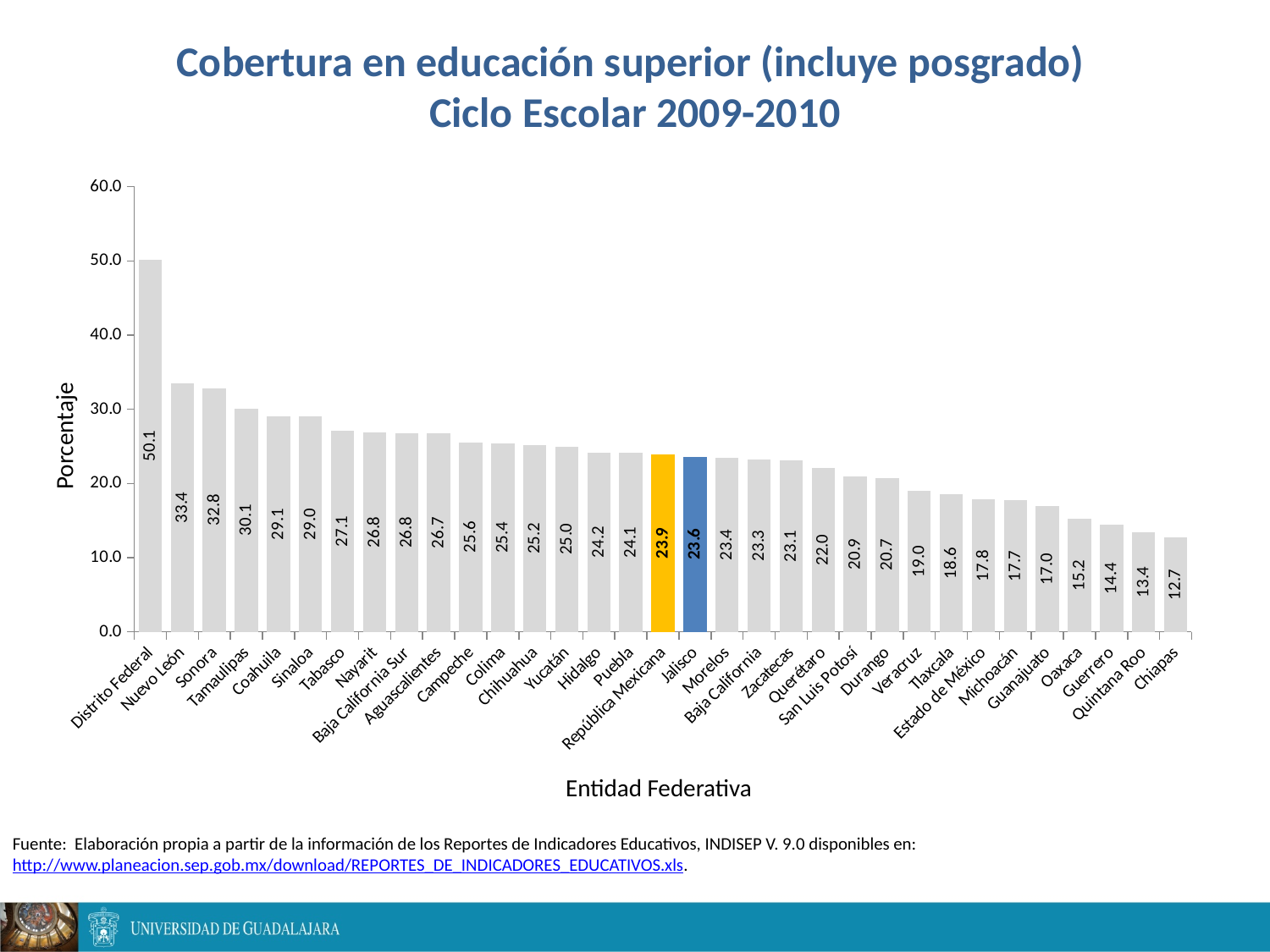
How many bars are shown in the chart? 33 What is the value for República Mexicana? 23.9 What kind of chart is shown on the slide? bar chart What is the value for Jalisco? 23.6 Which entidad federativa has the lowest value? Chiapas Do the values rise or fall from left to right along the x axis? fall Which has a larger value, Nuevo León or Sonora? Nuevo León What is the difference between the values for República Mexicana and Jalisco? 0.3 Which entidad federativa has the highest value? Distrito Federal Is the value for Veracruz greater or less than 20.0? less What is the difference between the values for Distrito Federal and Chiapas? 37.4 What is the value for Tlaxcala? 18.6